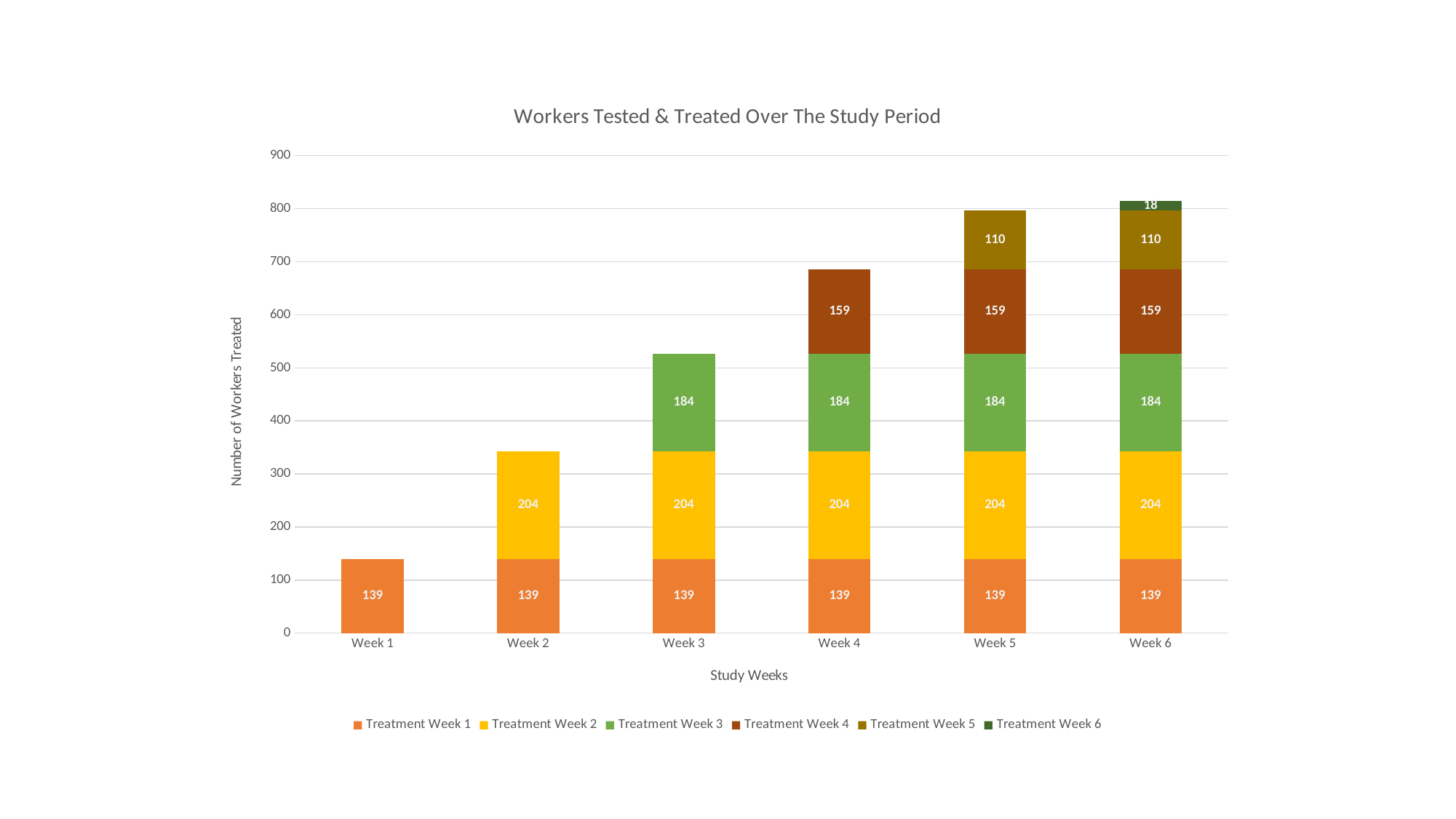
What is the value of Treatment Week 2 in the Week 4 bar? 204 What is the total of the stacked bar for Week 6? 814 What is the difference between the Treatment Week 2 value and the Treatment Week 1 value in the Week 2 bar? 65 What is the value of Treatment Week 4 in the Week 5 bar? 159 What type of chart is shown on the slide? Stacked bar chart How many study weeks are shown on the x axis? 6 How many series does the legend list? 6 What is the value of Treatment Week 6 in the Week 6 bar? 18 Which study week has the lowest total bar? Week 1 Do the total bar heights rise or fall from Week 1 to Week 6? Rise What is the total of the stacked bar for Week 3? 527 What is the title of the chart? Workers Tested & Treated Over The Study Period